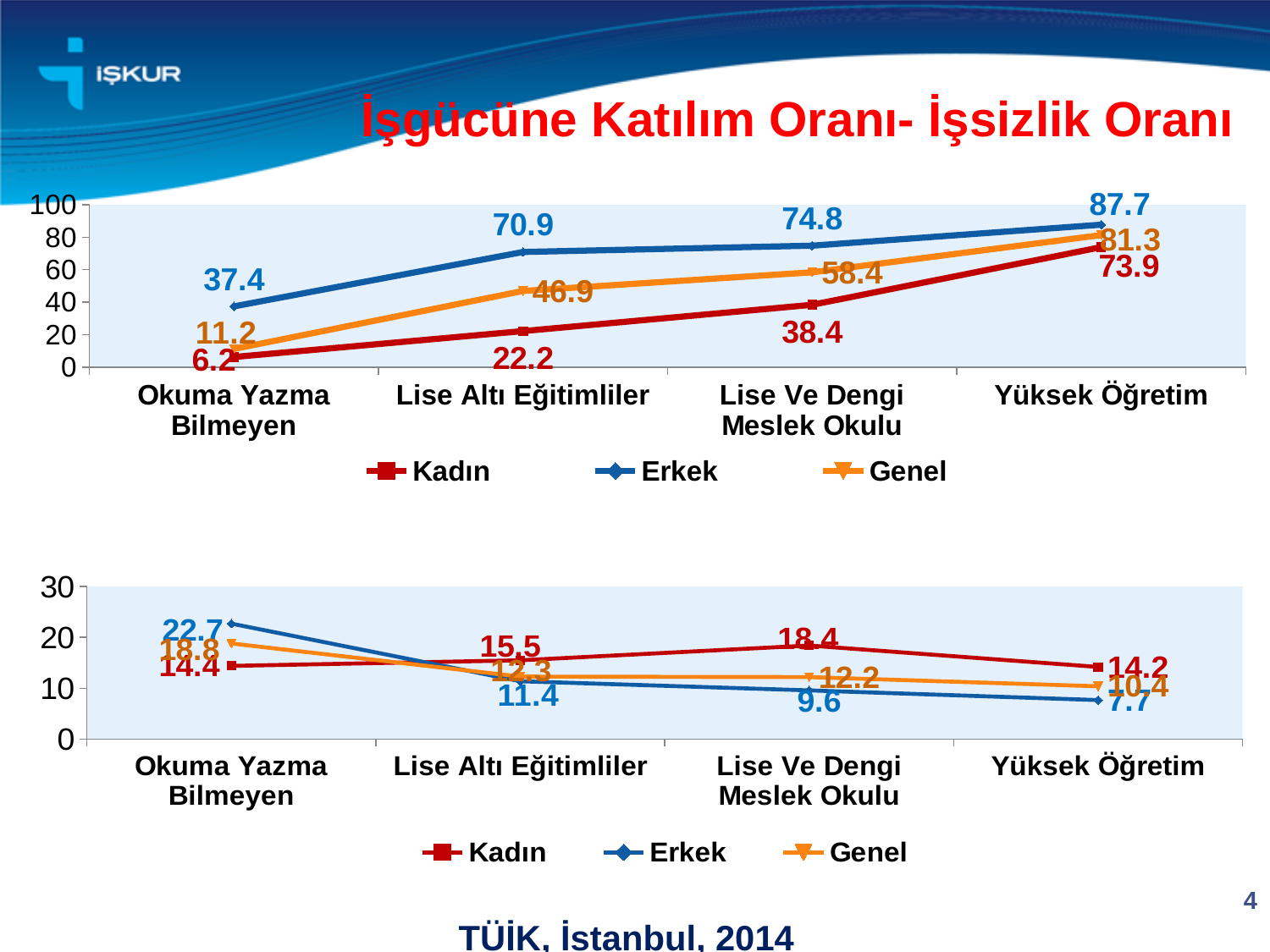
In the top chart, what is the difference between the Erkek and Kadın values at Lise Ve Dengi Meslek Okulu? 36.4 What type of chart is the top chart on the slide? line chart In the bottom chart, which category has the lowest value for Erkek? Yüksek Öğretim How many categories are shown on the x axis of the bottom chart? 4 In the top chart, what is the value for Kadın at Okuma Yazma Bilmeyen? 6.2 How many series does the legend of the bottom chart list? 3 In the bottom chart, what is the value for Erkek at Okuma Yazma Bilmeyen? 22.7 In the bottom chart, which is larger at Lise Ve Dengi Meslek Okulu: Kadın or Erkek? Kadın In the top chart, what is the value for Genel at Lise Altı Eğitimliler? 46.9 In the top chart, what is the value for Erkek at Yüksek Öğretim? 87.7 In the top chart, does the Kadın series rise or fall from Okuma Yazma Bilmeyen to Yüksek Öğretim? rise In the top chart, which category has the highest value for Kadın? Yüksek Öğretim